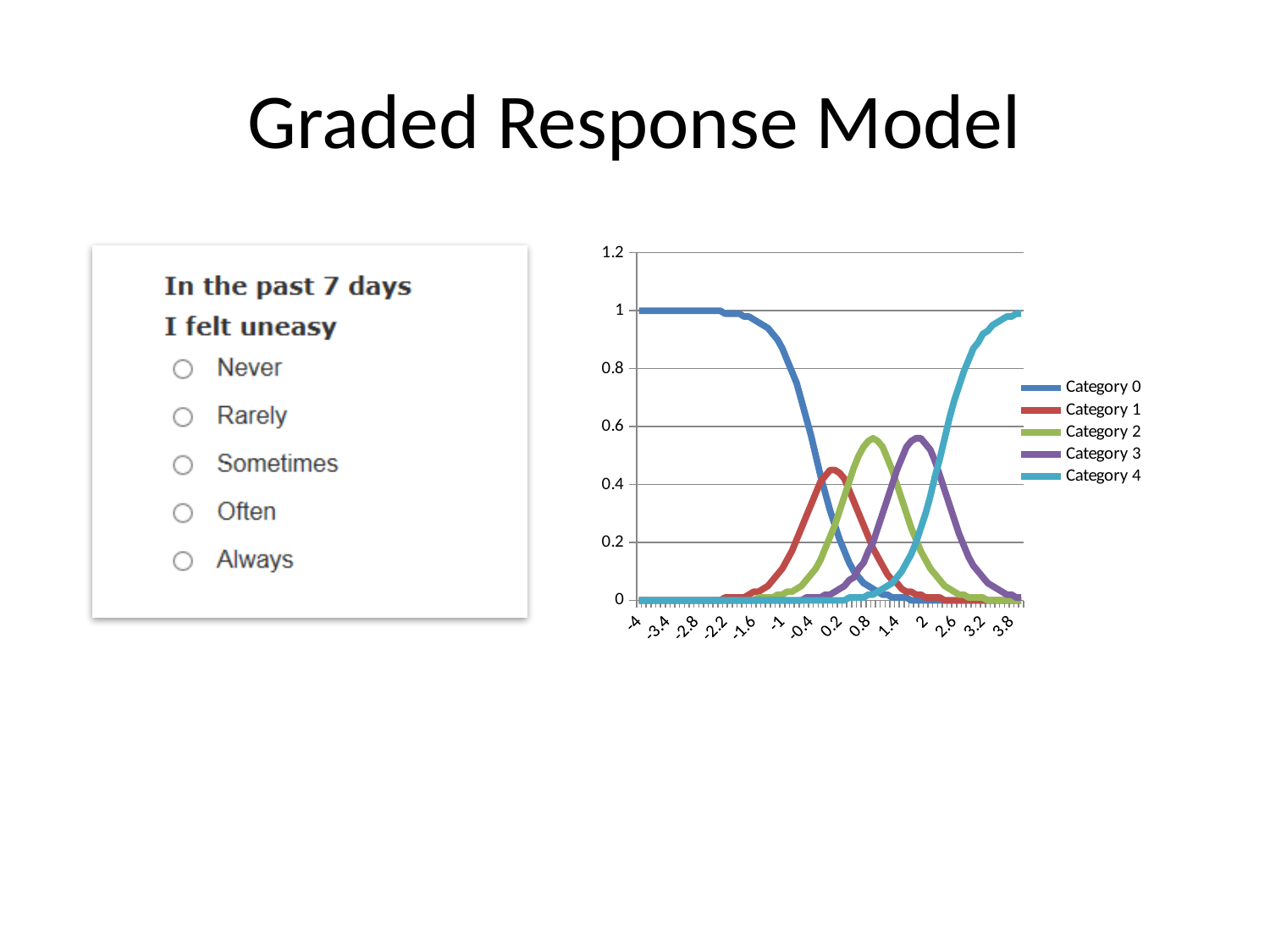
Does the Category 0 line rise or fall as the x axis moves from -4 to 3.8? fall Does the Category 4 line rise or fall as the x axis moves from -4 to 3.8? rise What is the highest value labelled on the chart's y axis? 1.2 Is the value of Category 0 at x = -4 greater or less than 0.8? greater Which line reaches a higher peak, Category 1 or Category 2? Category 2 What kind of chart is shown on the slide? line chart What colour is the Category 1 line in the legend? red Is the value of Category 0 at x = 2 greater or less than 0.2? less How many series does the chart's legend list? 5 Is the peak value of the Category 1 line greater or less than 0.6? less